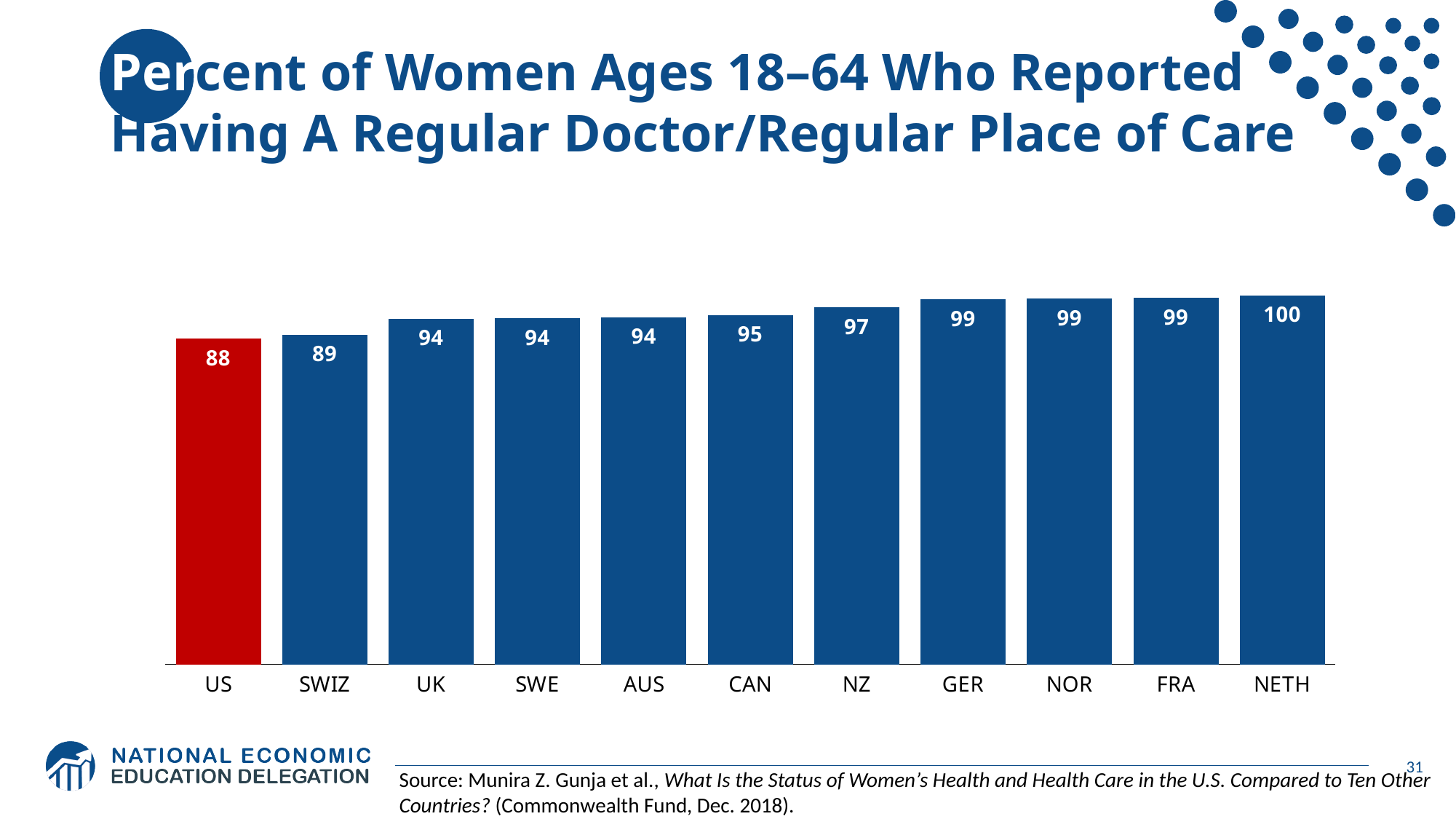
What kind of chart is shown on the slide? Bar chart What is the value for NZ? 97 What is the difference between the values for NETH and the US? 12 Do the values rise or fall from left to right across the chart? Rise Which country has the highest value? NETH What is the difference between the values for SWIZ and the US? 1 Which has a larger value, UK or NZ? NZ How many countries are shown in the chart? 11 Which bar is coloured red rather than blue? US What is the value for the US? 88 What is the value for CAN? 95 Which country has the lowest value? US